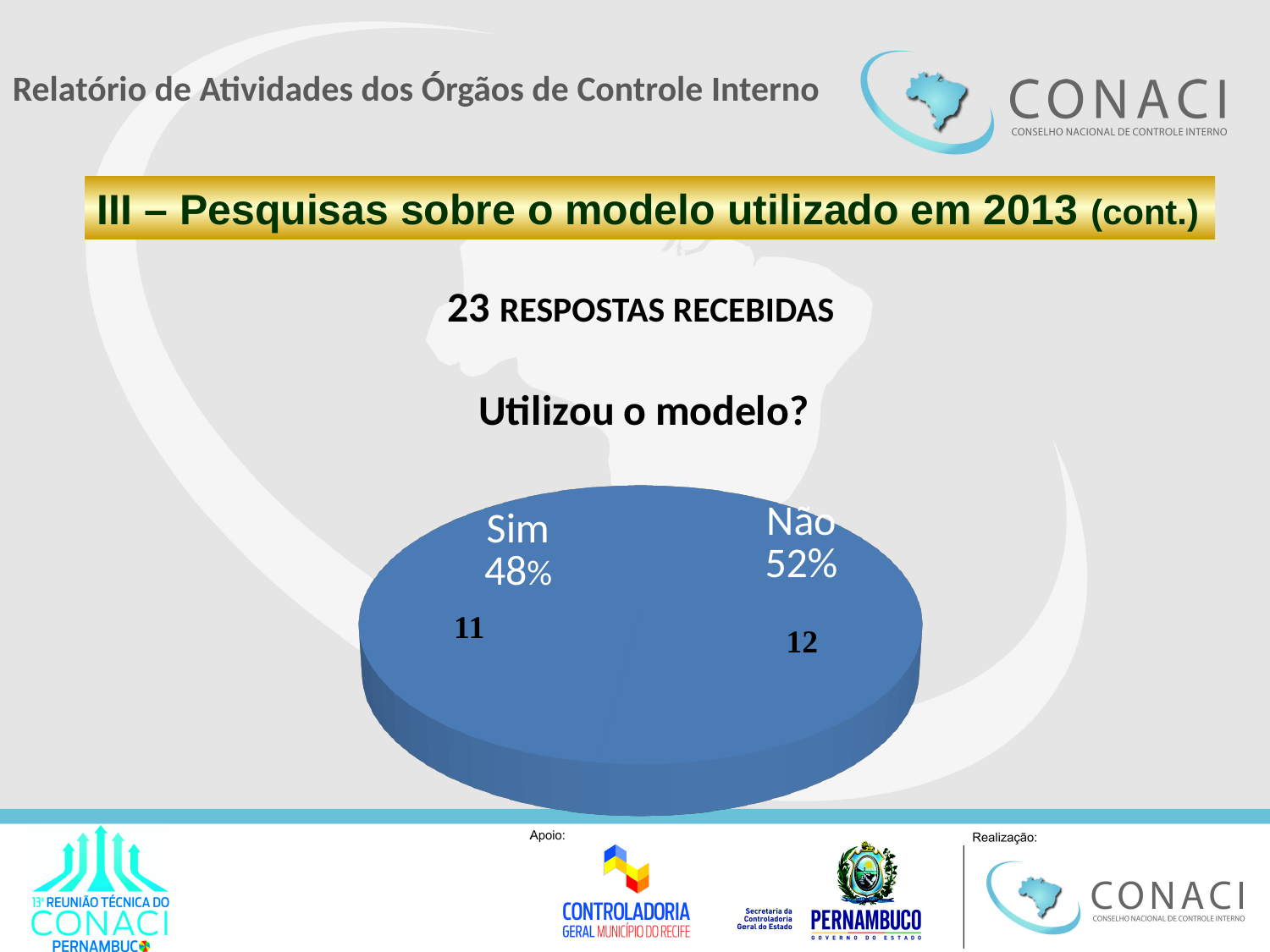
How many respondents answered "Não"? 12 How many slices does the pie chart have? 2 What question does the pie chart's title ask? Utilizou o modelo? How many respondents answered "Sim"? 11 What kind of chart is shown on the slide? pie chart What is the total number of responses shown in the pie chart? 23 What percentage of respondents answered "Não"? 52% How many responses were received according to the text above the chart? 23 What is the difference in number of responses between "Não" and "Sim"? 1 Which category has the smallest slice in the pie chart? Sim What percentage of respondents answered "Sim"? 48% Which answer has the larger slice, "Sim" or "Não"? Não